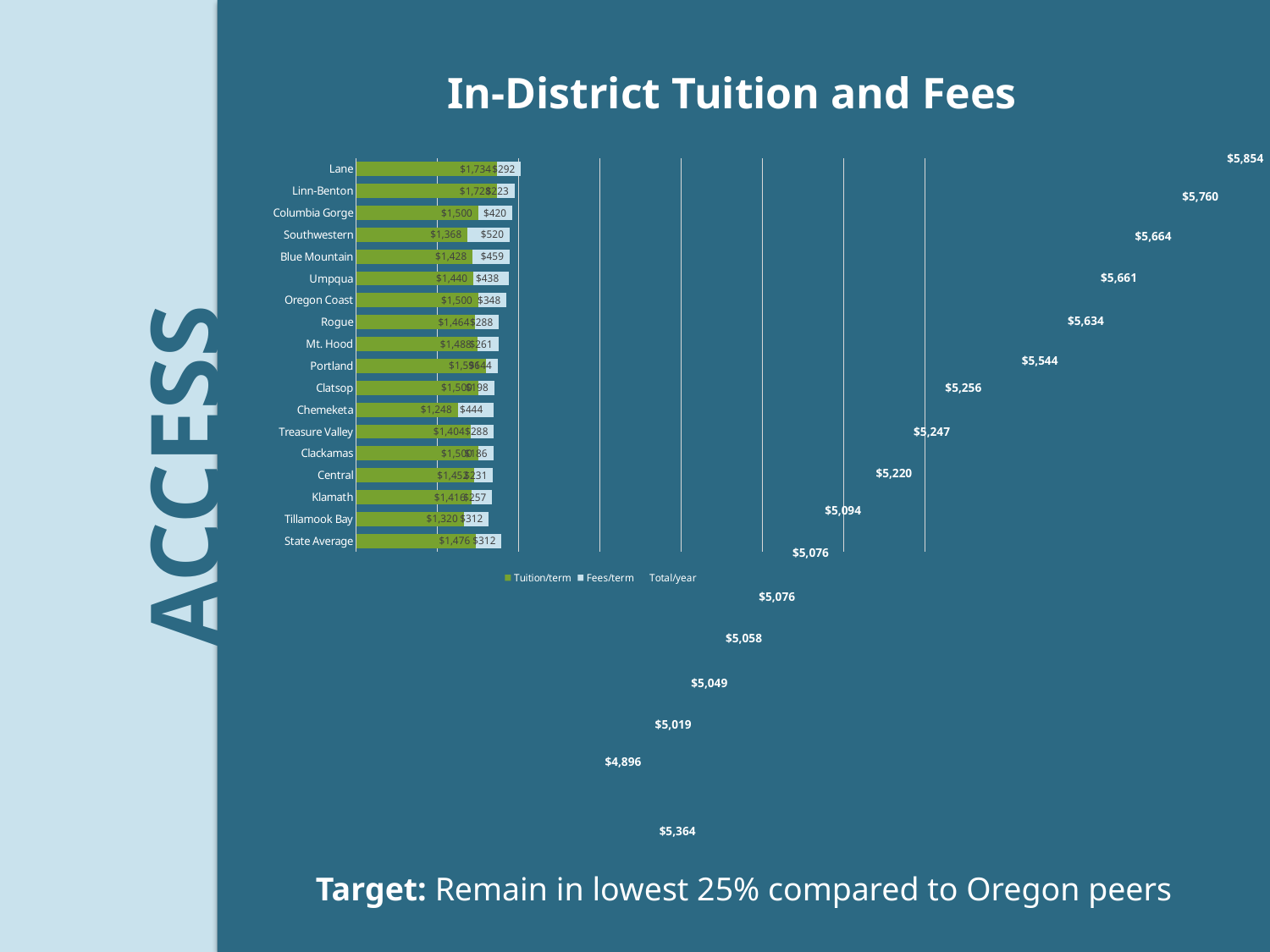
What is the Fees/term value for Southwestern? $520 What is the Tuition/term value for State Average? $1,476 What kind of chart is shown on the slide? bar chart What is the difference between the Tuition/term for Lane and for Chemeketa? $486 What is the combined Tuition/term and Fees/term for Southwestern? $1,888 Which category has the lowest Tuition/term? Chemeketa How many series does the legend list? 3 What is the title of the chart? In-District Tuition and Fees Which is larger, the Fees/term for Southwestern or for Tillamook Bay? Southwestern Which category has the highest Tuition/term? Lane How many categories (colleges plus State Average) are plotted on the chart? 18 What is the Tuition/term value for Lane? $1,734